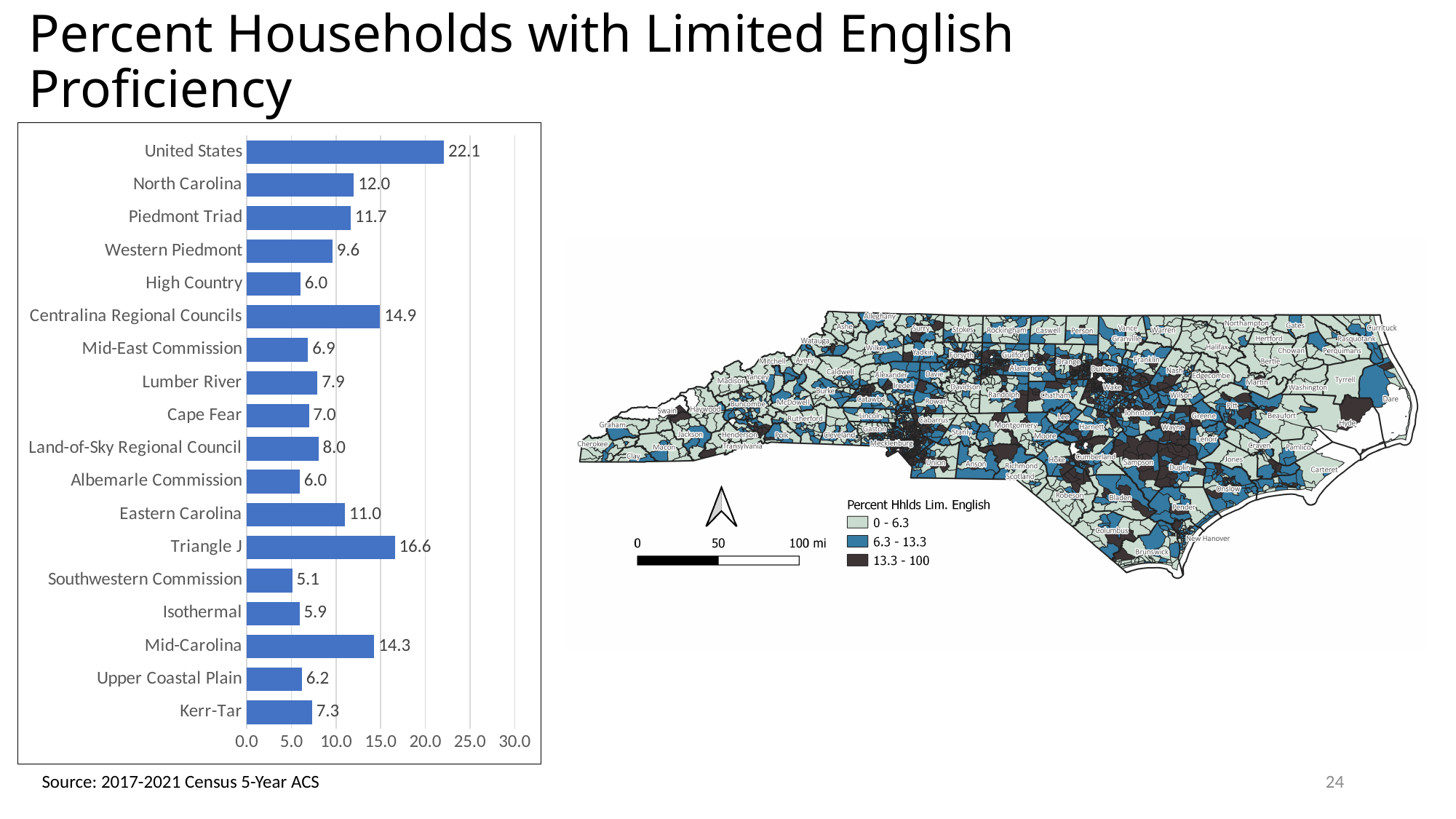
What is the difference between the values for United States and North Carolina in the bar chart? 10.1 What is the value for Triangle J in the bar chart? 16.6 Which category has the highest value in the bar chart? United States Which has a larger value in the bar chart, Piedmont Triad or Eastern Carolina? Piedmont Triad What is the value for North Carolina in the bar chart? 12.0 How many categories are shown in the bar chart? 18 Which category has the lowest value in the bar chart? Southwestern Commission What kind of chart is shown on the left of the slide? Bar chart What is the difference between the values for Triangle J and Mid-Carolina in the bar chart? 2.3 What is the value for Kerr-Tar in the bar chart? 7.3 What is the title of the slide containing the bar chart? Percent Households with Limited English Proficiency What is the value for Centralina Regional Councils in the bar chart? 14.9